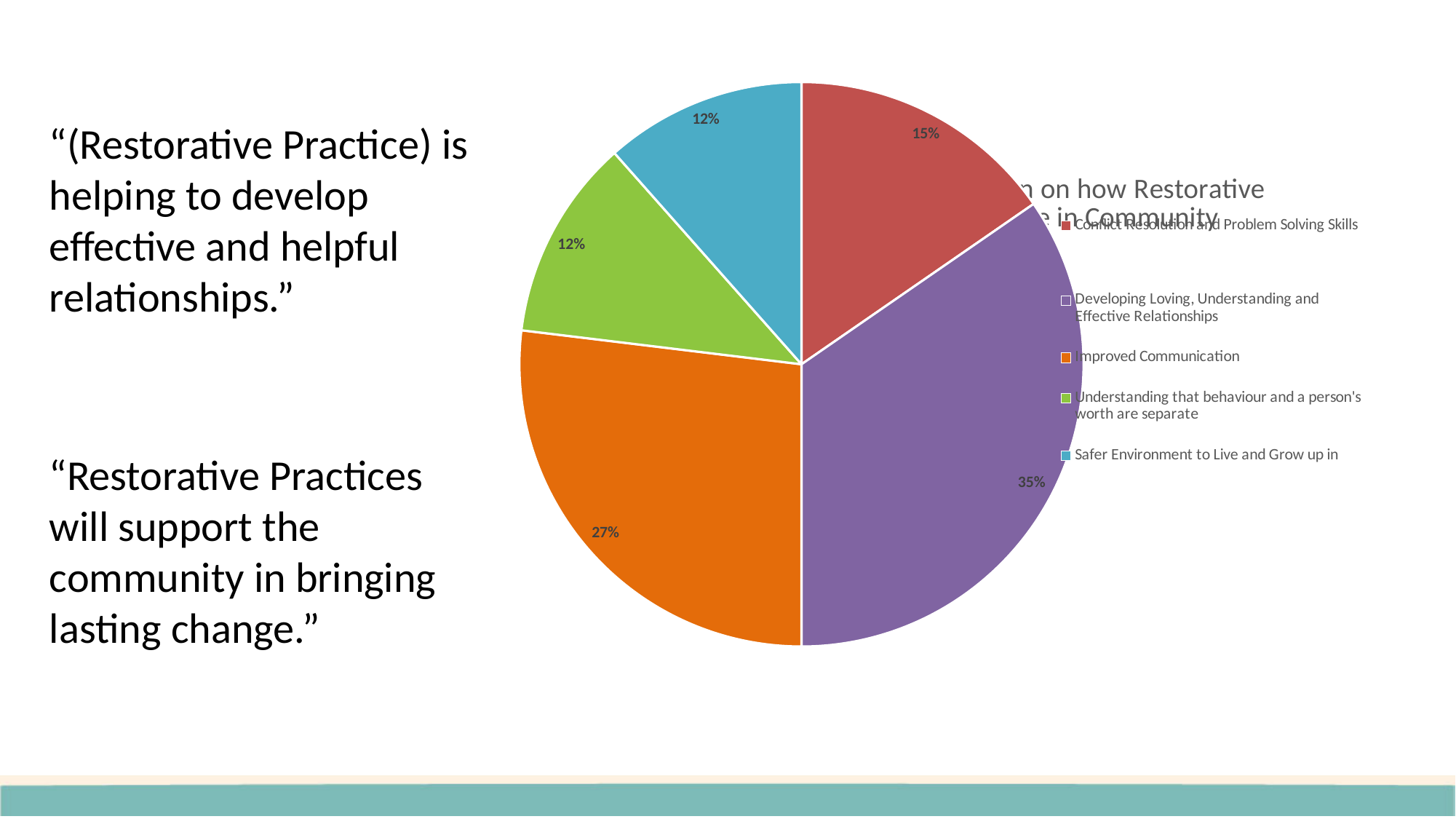
What percentage of the pie is labelled for Safer Environment to Live and Grow up in? 12% What kind of chart is shown on the slide? pie chart Which is larger: the share for Improved Communication or the share for Conflict Resolution and Problem Solving Skills? Improved Communication Which category has the largest share of the pie? Developing Loving, Understanding and Effective Relationships What colour is the slice for Safer Environment to Live and Grow up in? blue What percentage of the pie is labelled for Developing Loving, Understanding and Effective Relationships? 35% What percentage of the pie is labelled for Improved Communication? 27% How many slices does the pie chart have? 5 What colour is the slice for Improved Communication? orange What is the difference in percentage points between Developing Loving, Understanding and Effective Relationships and Improved Communication? 8 What percentage of the pie is labelled for Conflict Resolution and Problem Solving Skills? 15% How many entries does the legend list? 5